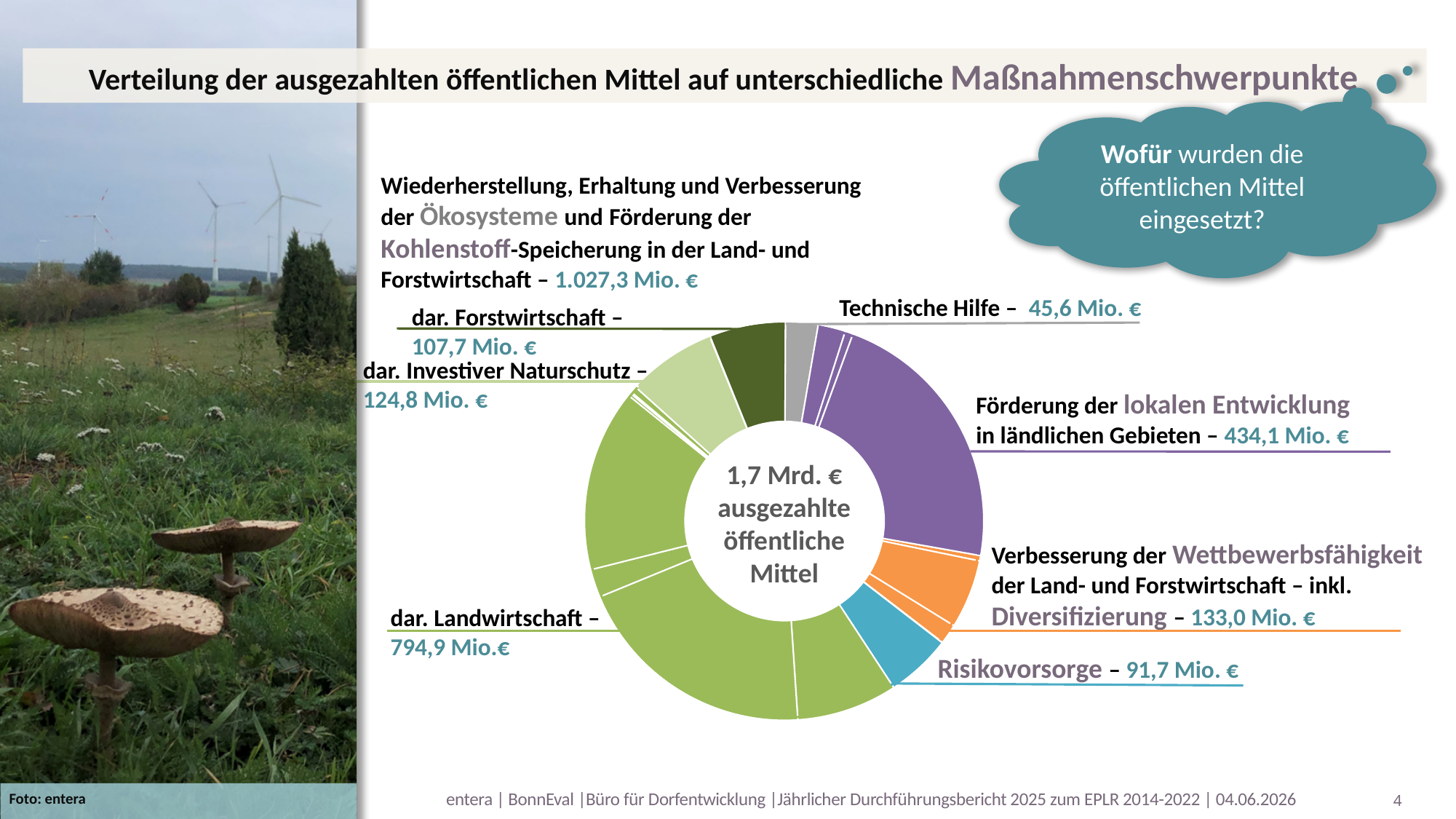
What value is shown for Technische Hilfe? 45,6 Mio. € Which main measure area received the smallest amount of public funds? Technische Hilfe What is the difference between Förderung der lokalen Entwicklung (434,1 Mio. €) and Verbesserung der Wettbewerbsfähigkeit (133,0 Mio. €)? 301,1 Mio. € Which main measure area received the largest amount of public funds? Wiederherstellung, Erhaltung und Verbesserung der Ökosysteme und Förderung der Kohlenstoff-Speicherung in der Land- und Forstwirtschaft What is the difference between dar. Investiver Naturschutz and dar. Forstwirtschaft? 17,1 Mio. € Which is larger: Risikovorsorge or Verbesserung der Wettbewerbsfähigkeit? Verbesserung der Wettbewerbsfähigkeit What value is shown for the sub-item dar. Landwirtschaft? 794,9 Mio.€ What value is shown for Risikovorsorge? 91,7 Mio. € What kind of chart is shown on the slide? Donut (pie) chart What total amount is written in the centre of the chart? 1,7 Mrd. € ausgezahlte öffentliche Mittel What value is shown for Verbesserung der Wettbewerbsfähigkeit der Land- und Forstwirtschaft – inkl. Diversifizierung? 133,0 Mio. € What value is shown for Förderung der lokalen Entwicklung in ländlichen Gebieten? 434,1 Mio. €